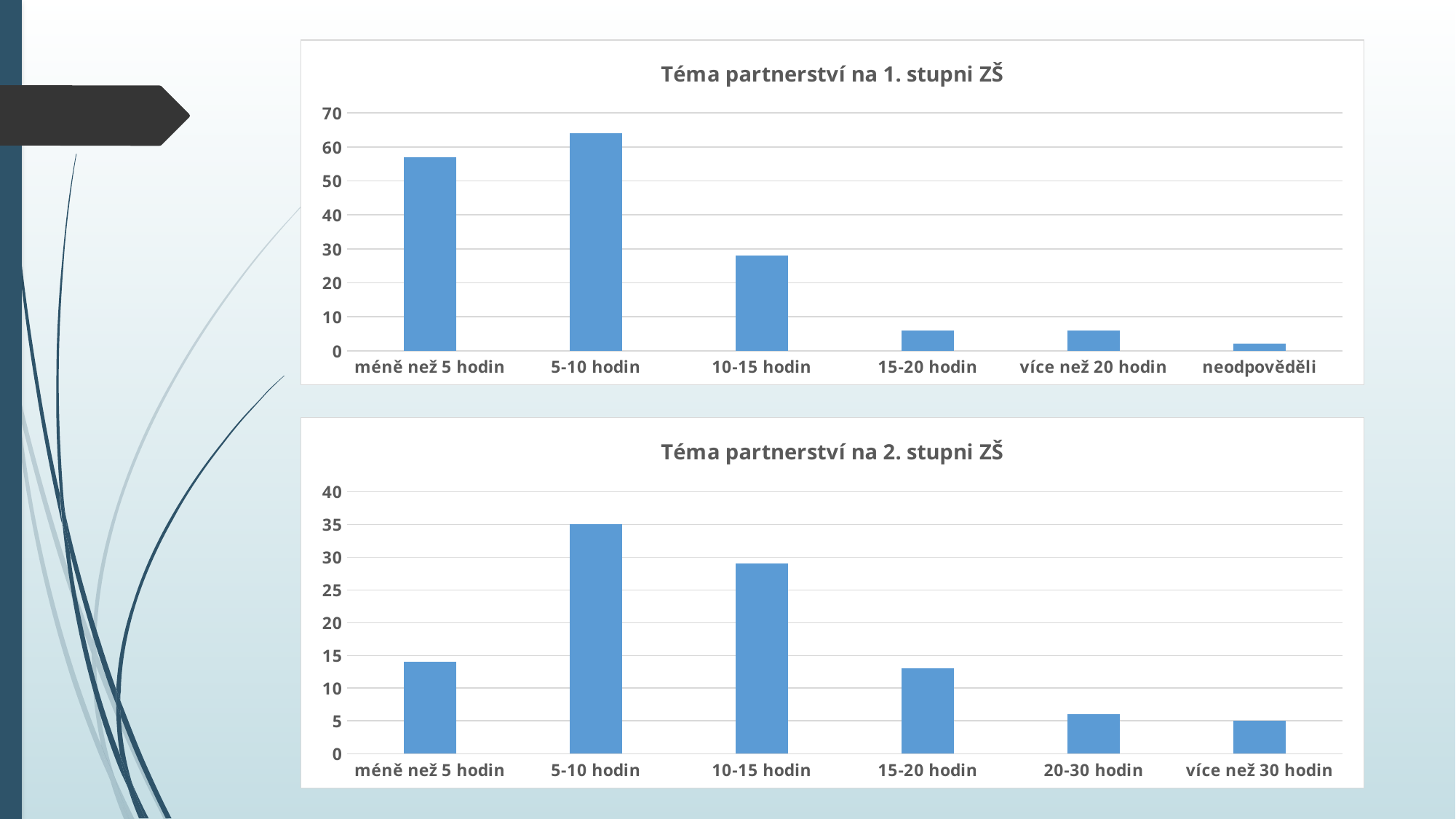
What is the title of the bottom chart on the slide? Téma partnerství na 2. stupni ZŠ In the chart 'Téma partnerství na 2. stupni ZŠ', which category has the highest value? 5-10 hodin In the chart 'Téma partnerství na 1. stupni ZŠ', which category has the lowest value? neodpověděli In the chart 'Téma partnerství na 1. stupni ZŠ', which category has the highest value? 5-10 hodin In the chart 'Téma partnerství na 2. stupni ZŠ', which category has the lowest value? více než 30 hodin In the chart 'Téma partnerství na 1. stupni ZŠ', is the value for 'méně než 5 hodin' greater or less than 50? greater In the chart 'Téma partnerství na 1. stupni ZŠ', is the value for '10-15 hodin' greater or less than 30? less How many categories are shown in the chart 'Téma partnerství na 1. stupni ZŠ'? 6 What type of chart is 'Téma partnerství na 1. stupni ZŠ'? bar chart In the chart 'Téma partnerství na 2. stupni ZŠ', which is larger: 'méně než 5 hodin' or '10-15 hodin'? 10-15 hodin In the chart 'Téma partnerství na 2. stupni ZŠ', is the value for '10-15 hodin' greater or less than 25? greater